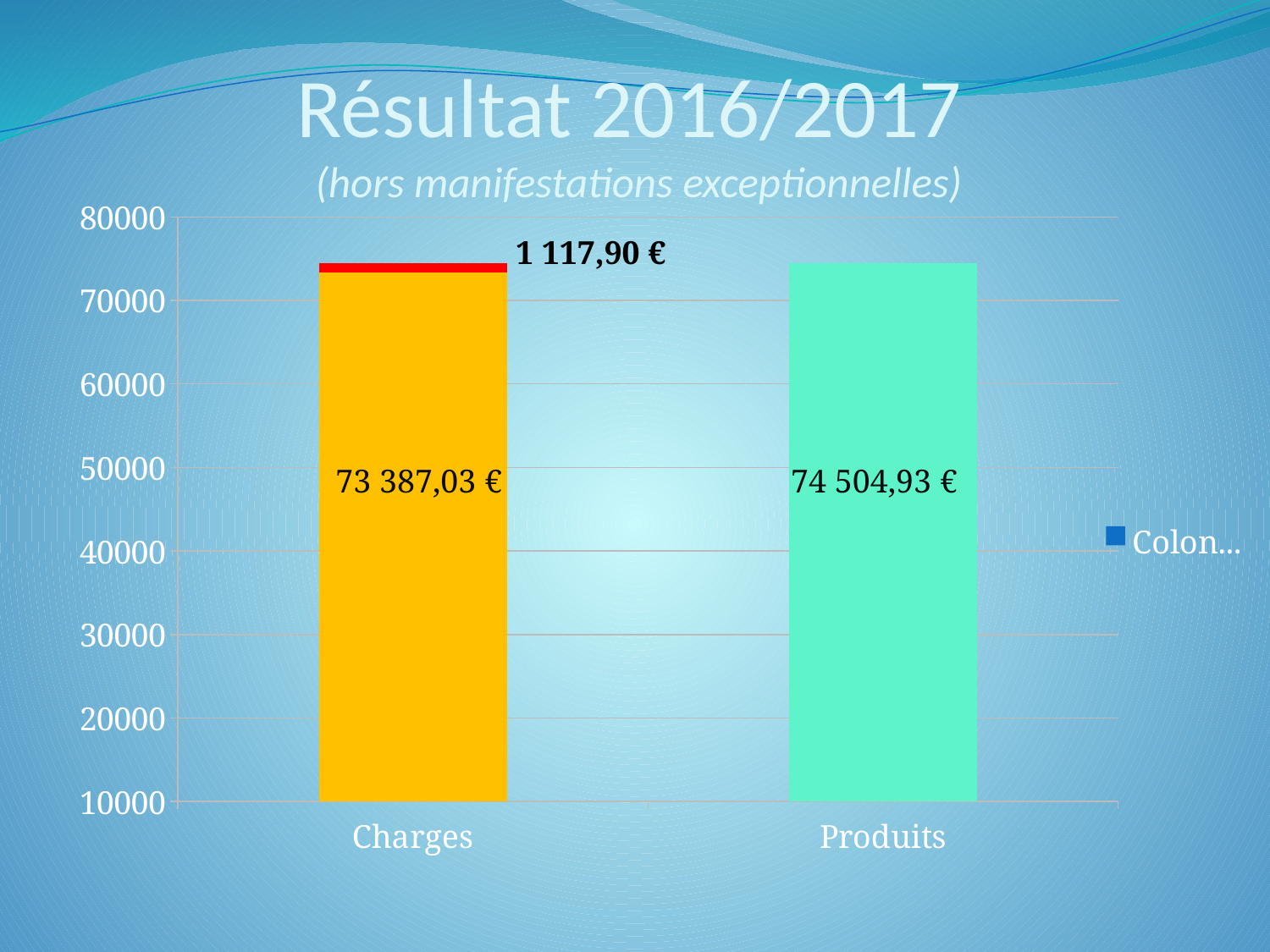
What kind of chart is shown on the slide? bar chart What is the value shown for Produits? 74 504,93 € What is the difference between the Produits value and the Charges value? 1 117,90 € Is the value for Charges greater or less than 70000? greater Which category has the lowest value? Charges What value is printed next to the red segment on top of the Charges bar? 1 117,90 € What is the total of the Charges bar including the red segment on top? 74 504,93 € What is the title of the slide? Résultat 2016/2017 Is the value for Produits greater or less than 80000? less How many categories are shown on the x axis? 2 Which category has the higher value, Charges or Produits? Produits What is the value shown for Charges? 73 387,03 €